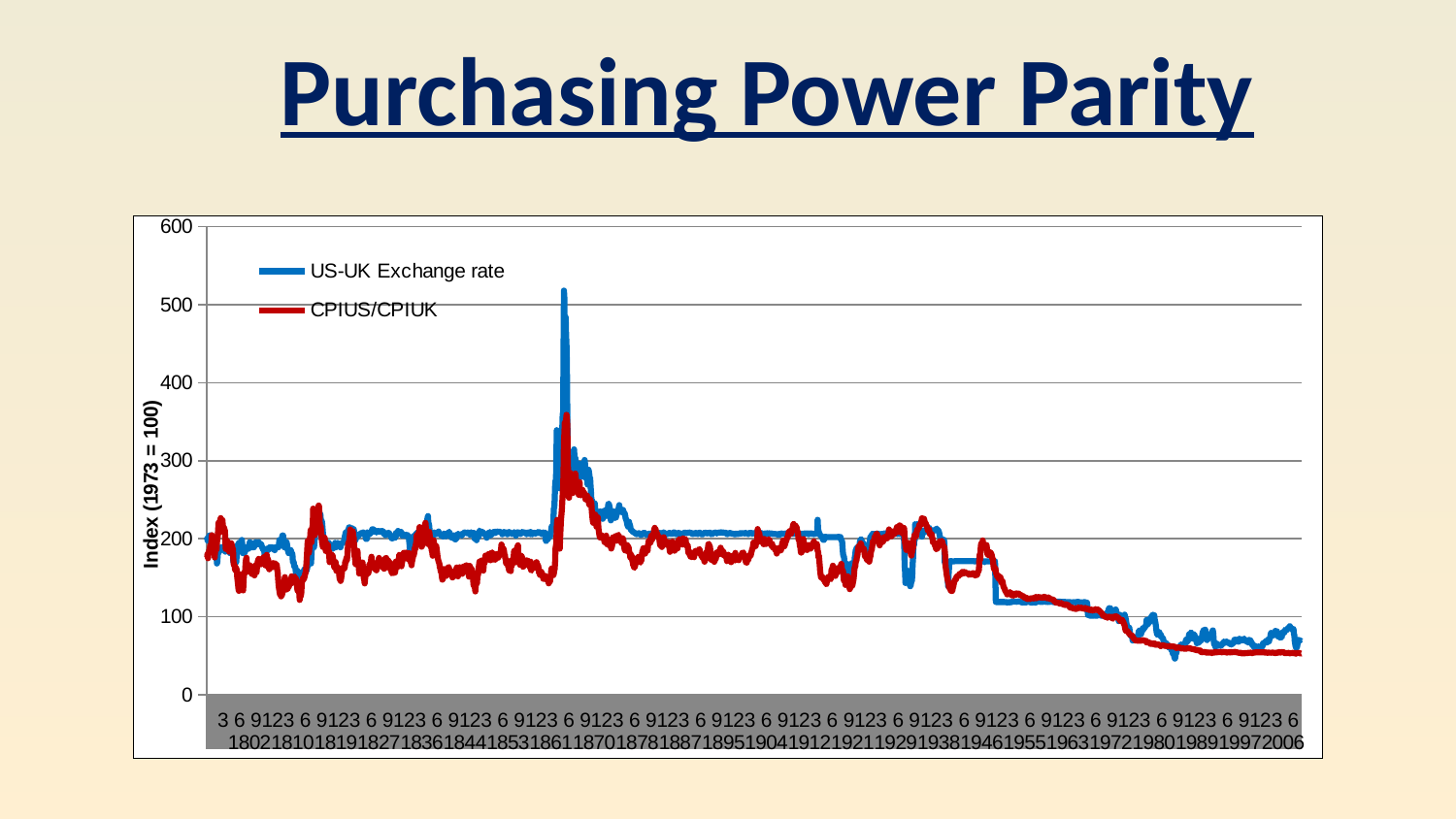
Is the value of the US-UK Exchange rate series at the left end of the chart (around 1802) greater or less than 100? greater Overall, do the plotted values rise or fall from the left of the x axis to the right? fall Is the value of the CPIUS/CPIUK series at the right end of the chart (around 2006) greater or less than 100? less Is the highest peak of the CPIUS/CPIUK series greater or less than 400? less What kind of chart is shown on the slide? line chart What is the highest tick value shown on the vertical axis? 600 Which series is drawn in blue? US-UK Exchange rate What is the title of the slide's chart? Purchasing Power Parity How many series does the legend list? 2 Which series reaches the higher peak, US-UK Exchange rate or CPIUS/CPIUK? US-UK Exchange rate